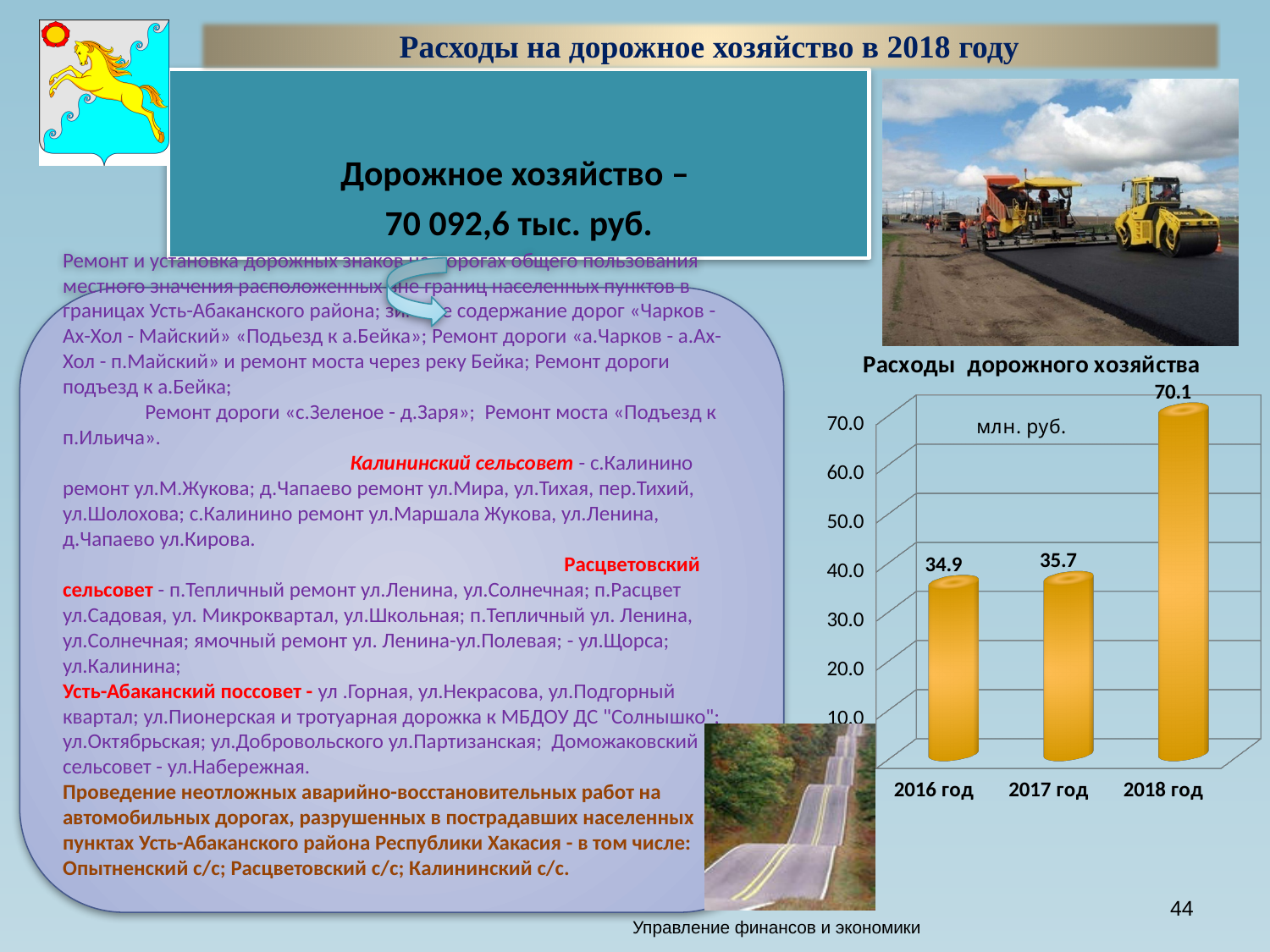
Which year has the lowest value in the chart? 2016 год What kind of chart is shown on the slide? bar chart What is the title of the chart? Расходы дорожного хозяйства How many years are shown in the chart? 3 What is the difference between the values for 2018 год and 2017 год? 34.4 Which year has the highest value in the chart? 2018 год What is the value for 2016 год in the chart? 34.9 Is the value for 2018 год greater or less than 60.0? greater Which is larger, the value for 2018 год or the value for 2016 год? 2018 год What is the value for 2018 год in the chart? 70.1 What is the difference between the values for 2017 год and 2016 год? 0.8 What is the value for 2017 год in the chart? 35.7